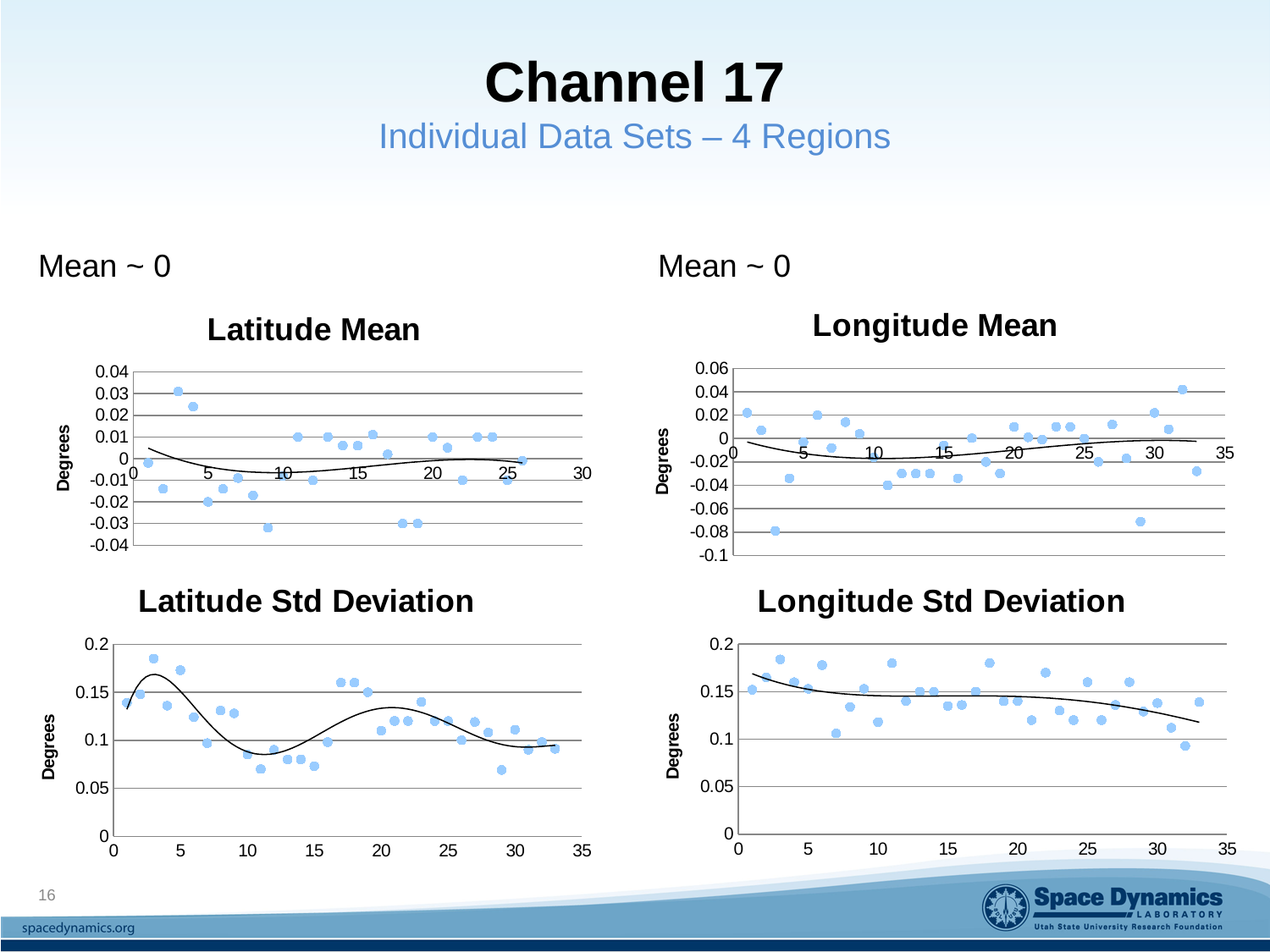
What is the y-axis label on the Longitude Std Deviation chart? Degrees In the Longitude Std Deviation chart, is the value at x = 32 greater or less than 0.1? less In the Latitude Mean chart, which is larger: the value at x = 3 or the value at x = 4? x = 3 What is the title of the chart in the top right of the slide? Longitude Mean In the Latitude Std Deviation chart, is the value at x = 11 greater or less than 0.1? less In the Latitude Std Deviation chart, is the value at x = 3 greater or less than 0.15? greater What kind of chart is the Latitude Mean chart? Scatter chart How many charts are shown on the slide? 4 What is the highest value shown on the y-axis of the Longitude Mean chart? 0.06 In the Longitude Mean chart, which is larger: the value at x = 2 or the value at x = 32? x = 32